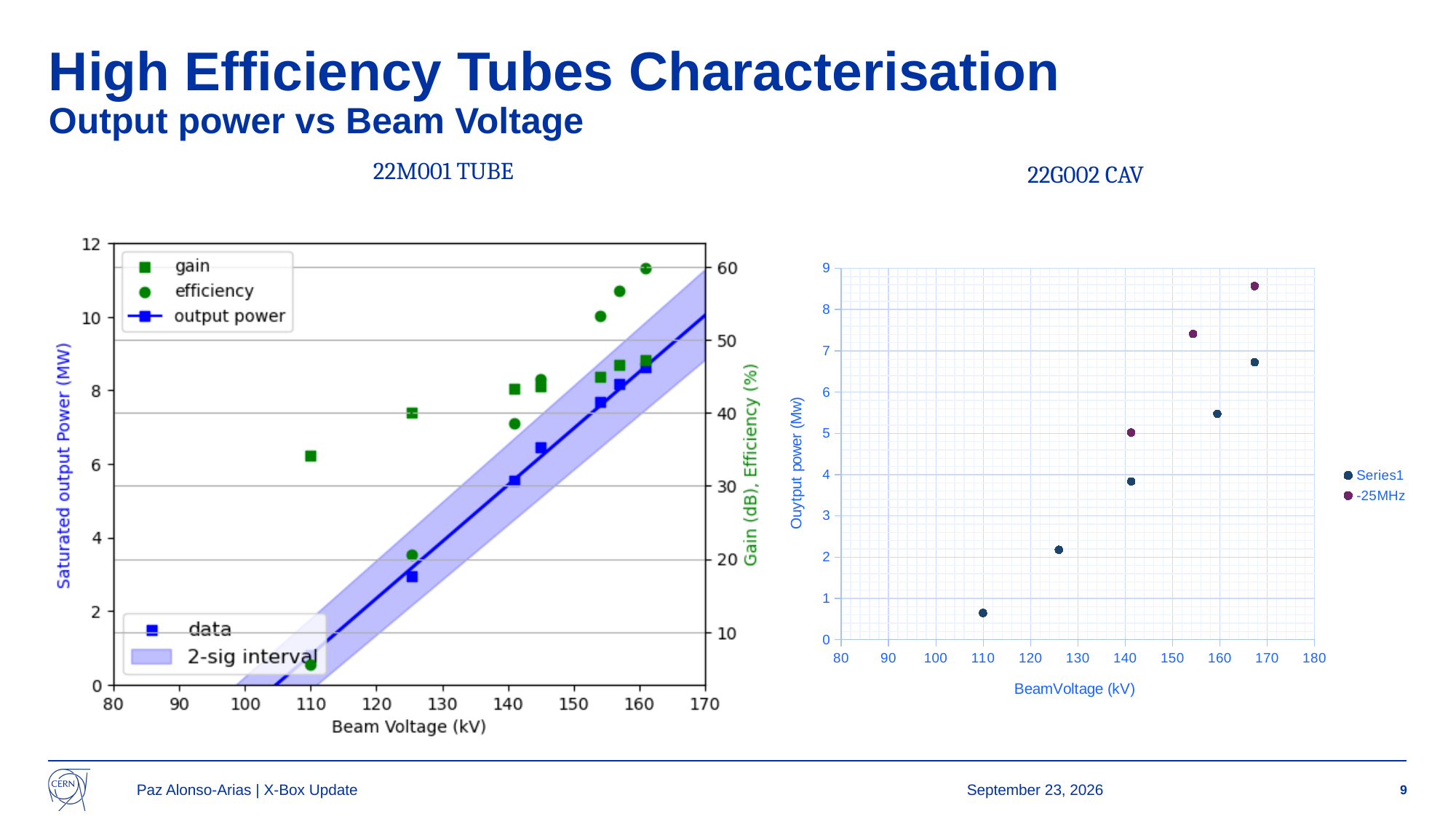
In the 22M001 TUBE chart, is the efficiency at about 161 kV greater or less than 50%? greater What kind of chart is the 22G002 CAV chart on the right? scatter chart In the 22G002 CAV chart, at about 141 kV, which series has the larger output power, Series1 or -25MHz? -25MHz In the 22G002 CAV chart, how many Series1 points are plotted? 5 In the 22G002 CAV chart, how many -25MHz points are plotted? 3 In the 22M001 TUBE chart, what is the label of the x axis? Beam Voltage (kV) How many series does the legend of the 22G002 CAV chart list? 2 In the 22G002 CAV chart, does output power rise or fall as beam voltage increases? rise In the 22M001 TUBE chart, is the output power at about 125 kV greater or less than 4 MW? less In the 22G002 CAV chart, is the -25MHz value at about 167 kV greater or less than 8? greater In the 22M001 TUBE chart, how many entries does the upper legend list? 3